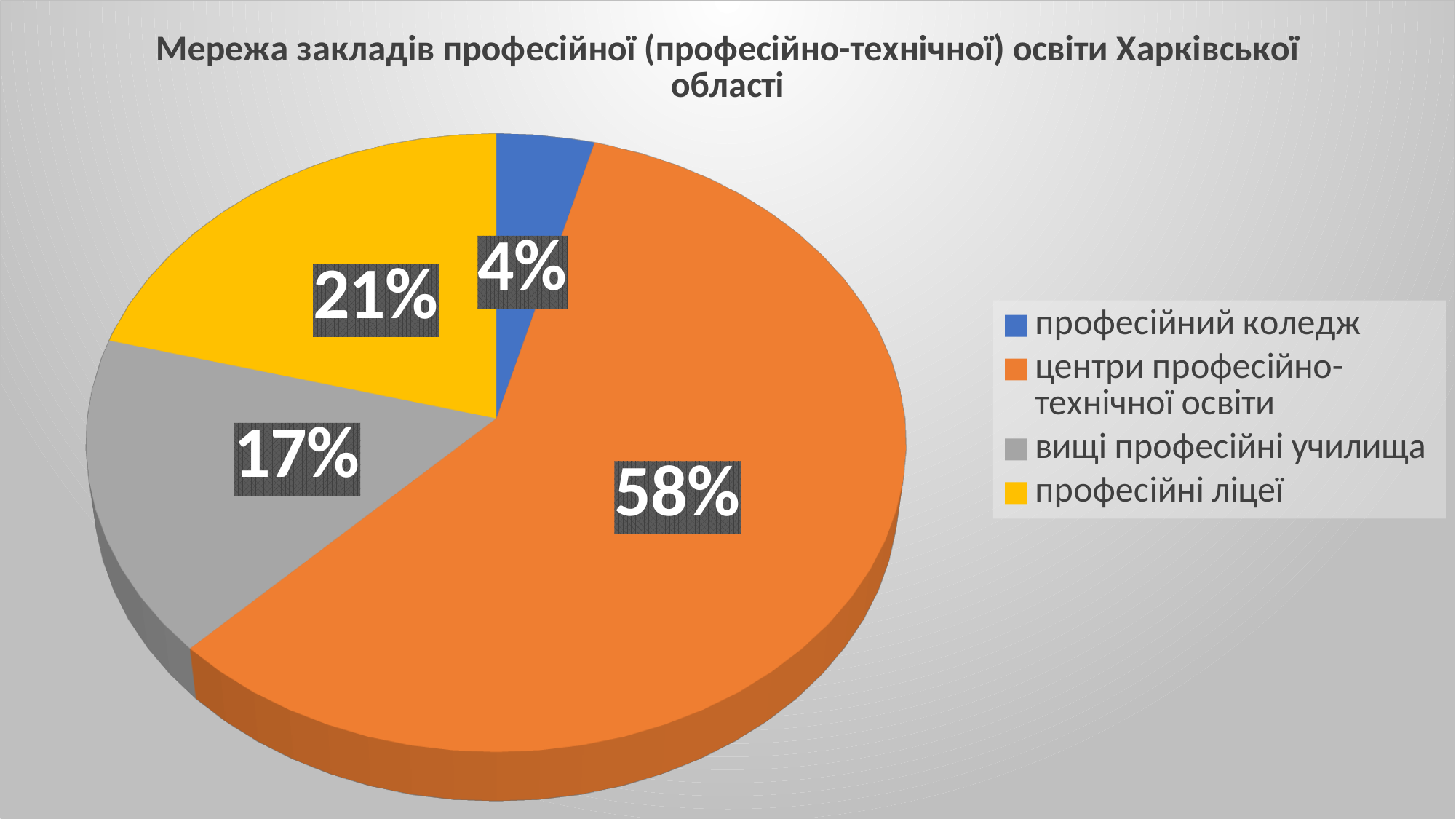
Which category has the largest slice of the pie? центри професійно-технічної освіти What share of the pie does 'центри професійно-технічної освіти' hold? 58% Which is larger: the share for 'професійні ліцеї' or the share for 'вищі професійні училища'? професійні ліцеї What kind of chart is shown on the slide? pie chart What share of the pie does 'вищі професійні училища' hold? 17% What is the difference in percentage points between 'центри професійно-технічної освіти' and 'професійний коледж'? 54 What colour is the slice for 'вищі професійні училища'? grey How many categories does the pie chart show? 4 What share of the pie does 'професійні ліцеї' hold? 21% What is the difference in percentage points between 'професійні ліцеї' and 'вищі професійні училища'? 4 Which category has the smallest slice of the pie? професійний коледж